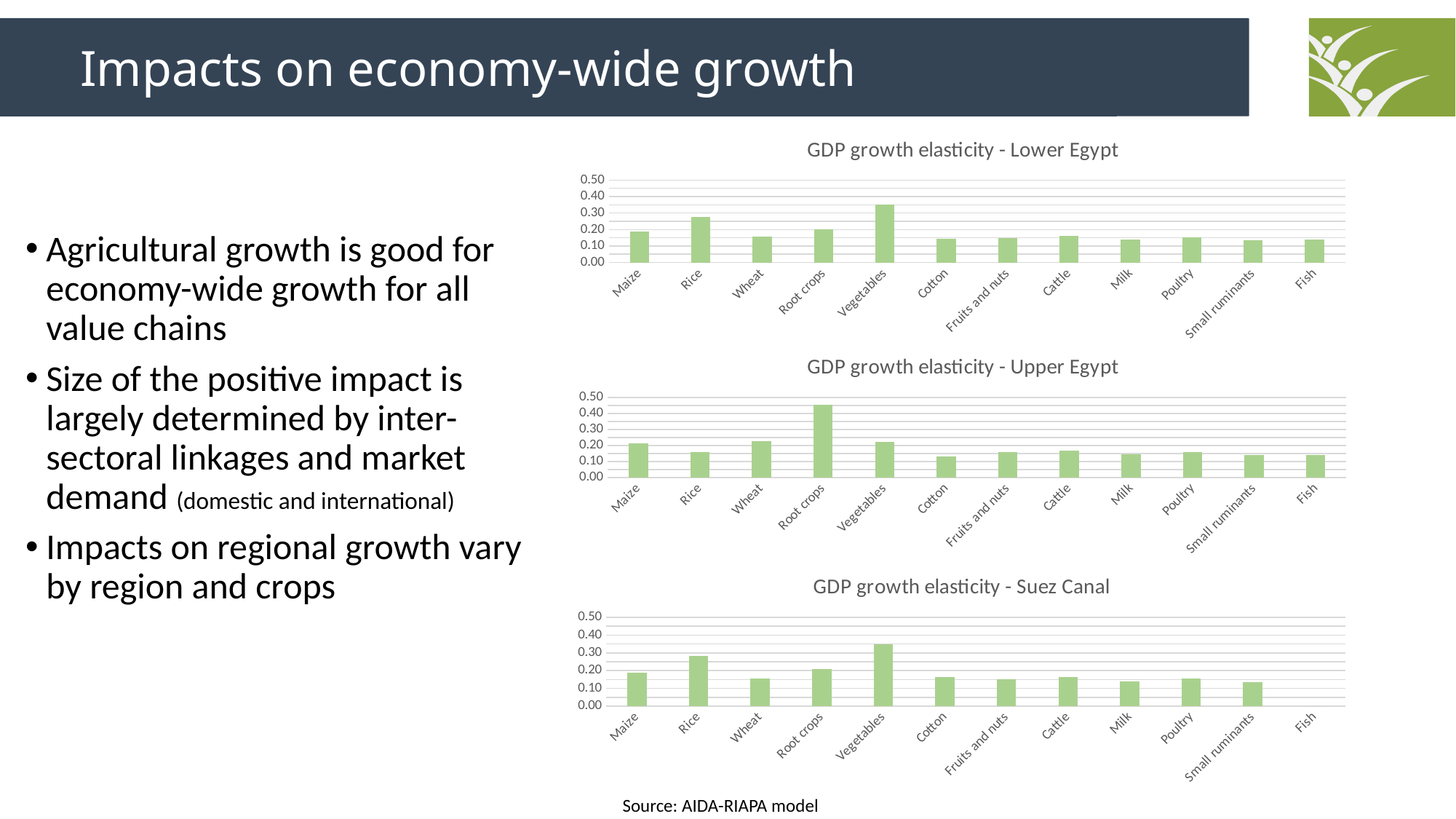
In the 'GDP growth elasticity - Lower Egypt' chart, is the value for Cotton greater or less than 0.20? less In the 'GDP growth elasticity - Suez Canal' chart, is the value for Rice greater or less than 0.20? greater In the 'GDP growth elasticity - Upper Egypt' chart, is the value for Root crops greater or less than 0.40? greater In the 'GDP growth elasticity - Upper Egypt' chart, which is larger, the value for Wheat or the value for Rice? Wheat How many charts are shown on the slide? 3 In the 'GDP growth elasticity - Lower Egypt' chart, which category has the highest value? Vegetables How many categories are shown on the x axis of the 'GDP growth elasticity - Lower Egypt' chart? 12 In the 'GDP growth elasticity - Upper Egypt' chart, which category has the highest value? Root crops In the 'GDP growth elasticity - Lower Egypt' chart, which is larger, the value for Rice or the value for Wheat? Rice In the 'GDP growth elasticity - Suez Canal' chart, which category has the highest value? Vegetables In the 'GDP growth elasticity - Suez Canal' chart, which category has the lowest value? Fish What kind of chart is 'GDP growth elasticity - Suez Canal'? Bar chart